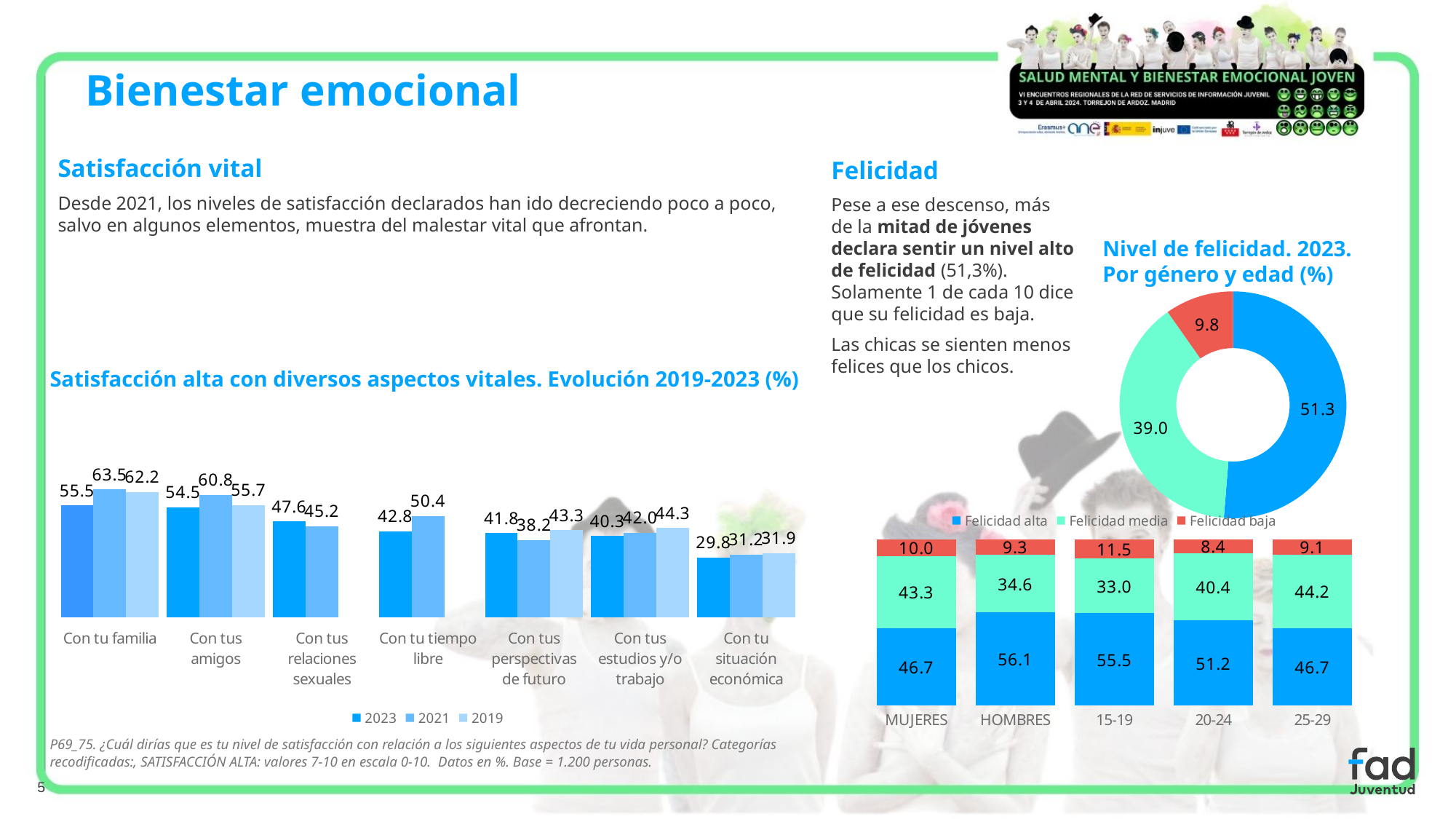
In the chart 'Satisfacción alta con diversos aspectos vitales. Evolución 2019-2023 (%)', how many series does the legend list? 3 In the chart 'Satisfacción alta con diversos aspectos vitales. Evolución 2019-2023 (%)', what is the 2023 value for 'Con tu familia'? 55.5 In the stacked bar chart at the bottom right (Felicidad alta/media/baja by gender and age), which group has the highest 'Felicidad baja' value? 15-19 In the chart 'Satisfacción alta con diversos aspectos vitales. Evolución 2019-2023 (%)', which category has the lowest 2023 value? Con tu situación económica What kind of chart is 'Nivel de felicidad. 2023. Por género y edad (%)' at the top right? Donut (pie) chart In the donut chart 'Nivel de felicidad. 2023. Por género y edad (%)', what is the value of the 'Felicidad media' slice? 39.0 In the chart 'Satisfacción alta con diversos aspectos vitales. Evolución 2019-2023 (%)', what is the 2021 value for 'Con tus amigos'? 60.8 In the chart 'Satisfacción alta con diversos aspectos vitales. Evolución 2019-2023 (%)', what is the difference between the 2021 and 2023 values for 'Con tu familia'? 8.0 In the stacked bar chart at the bottom right (Felicidad alta/media/baja by gender and age), what is the 'Felicidad alta' value for HOMBRES? 56.1 In the chart 'Satisfacción alta con diversos aspectos vitales. Evolución 2019-2023 (%)', how many categories are shown on the x axis? 7 In the chart 'Satisfacción alta con diversos aspectos vitales. Evolución 2019-2023 (%)', which is larger for 'Con tu tiempo libre': the 2023 value or the 2021 value? 2021 In the stacked bar chart at the bottom right (Felicidad alta/media/baja by gender and age), what is the total of the MUJERES bar? 100.0